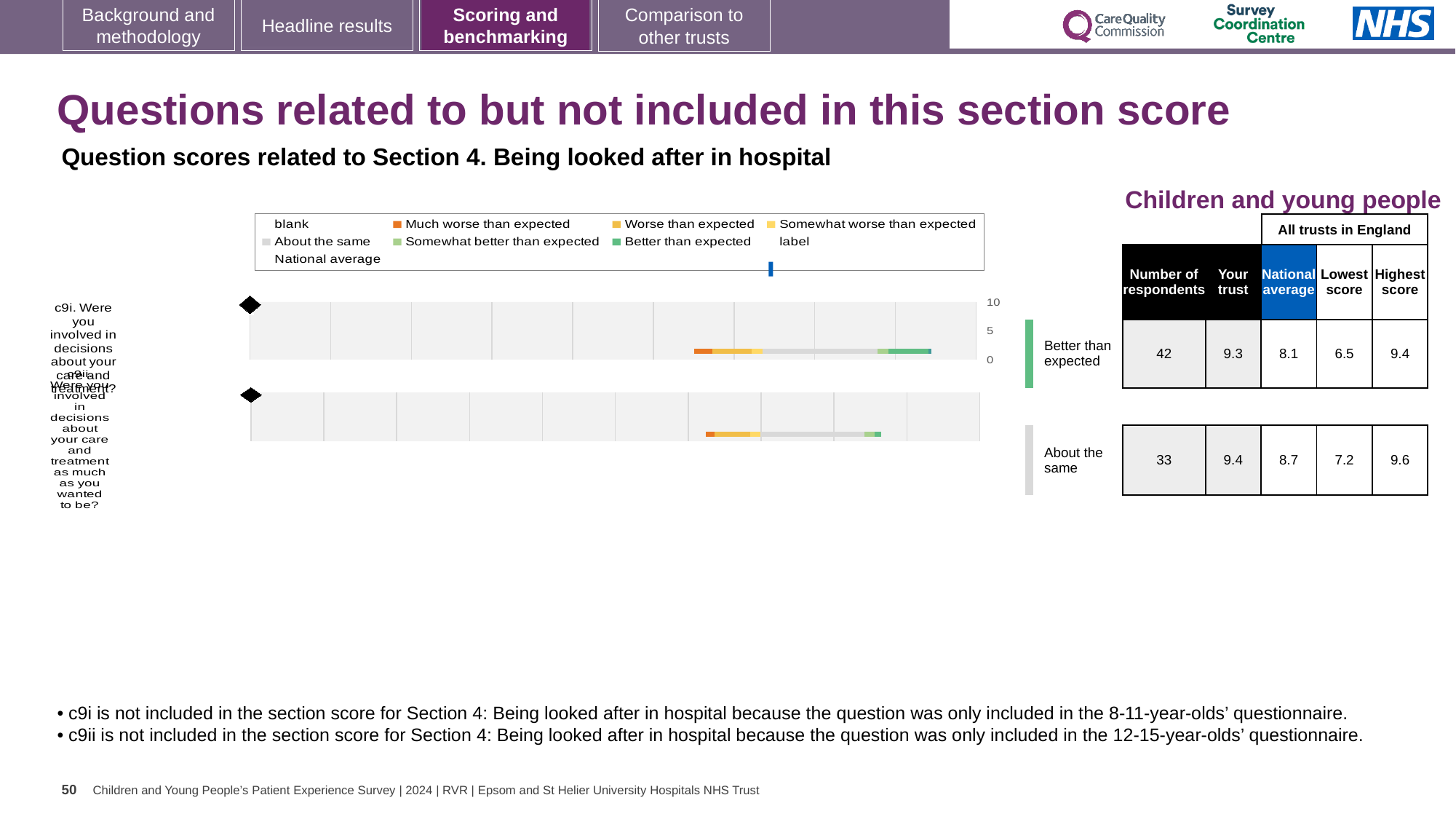
What is the difference between the trust's score and the national average for question c9i? 1.2 How many questions (bars) are plotted in the chart area? 2 What is the 'Your trust' score for question c9i? 9.3 What is the national average score for question c9ii? 8.7 For question c9i, which is larger: the trust's score or the national average? Your trust What is the difference between the highest and lowest scores for question c9ii? 2.4 What kind of chart is used to show the c9i and c9ii question scores? Bar chart Which benchmark category is shown for question c9i? Better than expected Which benchmark category is shown for question c9ii? About the same What is the maximum value shown on the chart's score axis? 10 What is the highest score across all trusts in England for question c9ii? 9.6 How many respondents answered question c9i? 42